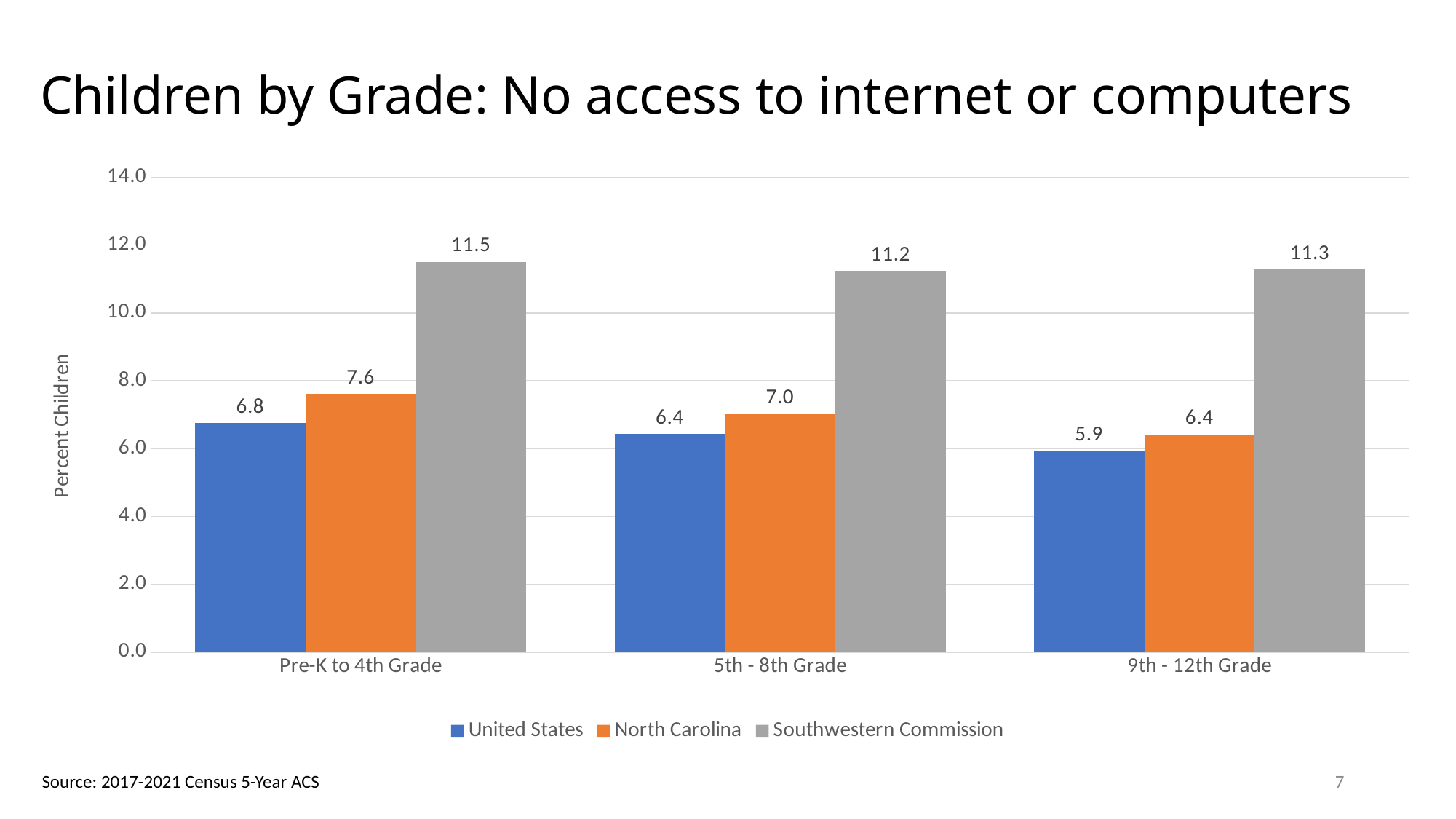
What is the value for North Carolina in the 5th - 8th Grade category? 7.0 Is the value for Southwestern Commission in the 5th - 8th Grade category greater or less than 10.0? greater What is the value for Southwestern Commission in the Pre-K to 4th Grade category? 11.5 What kind of chart is shown on the slide? Bar chart Which grade category has the highest value for the United States series? Pre-K to 4th Grade How many series does the legend list? 3 Which grade category has the lowest value for the Southwestern Commission series? 5th - 8th Grade How many grade categories are shown on the x axis? 3 Which is larger in the Pre-K to 4th Grade category: the United States value or the North Carolina value? North Carolina What is the difference between the Southwestern Commission and United States values in the 9th - 12th Grade category? 5.4 Do the United States values rise or fall from Pre-K to 4th Grade to 9th - 12th Grade? Fall What is the value for United States in the 9th - 12th Grade category? 5.9